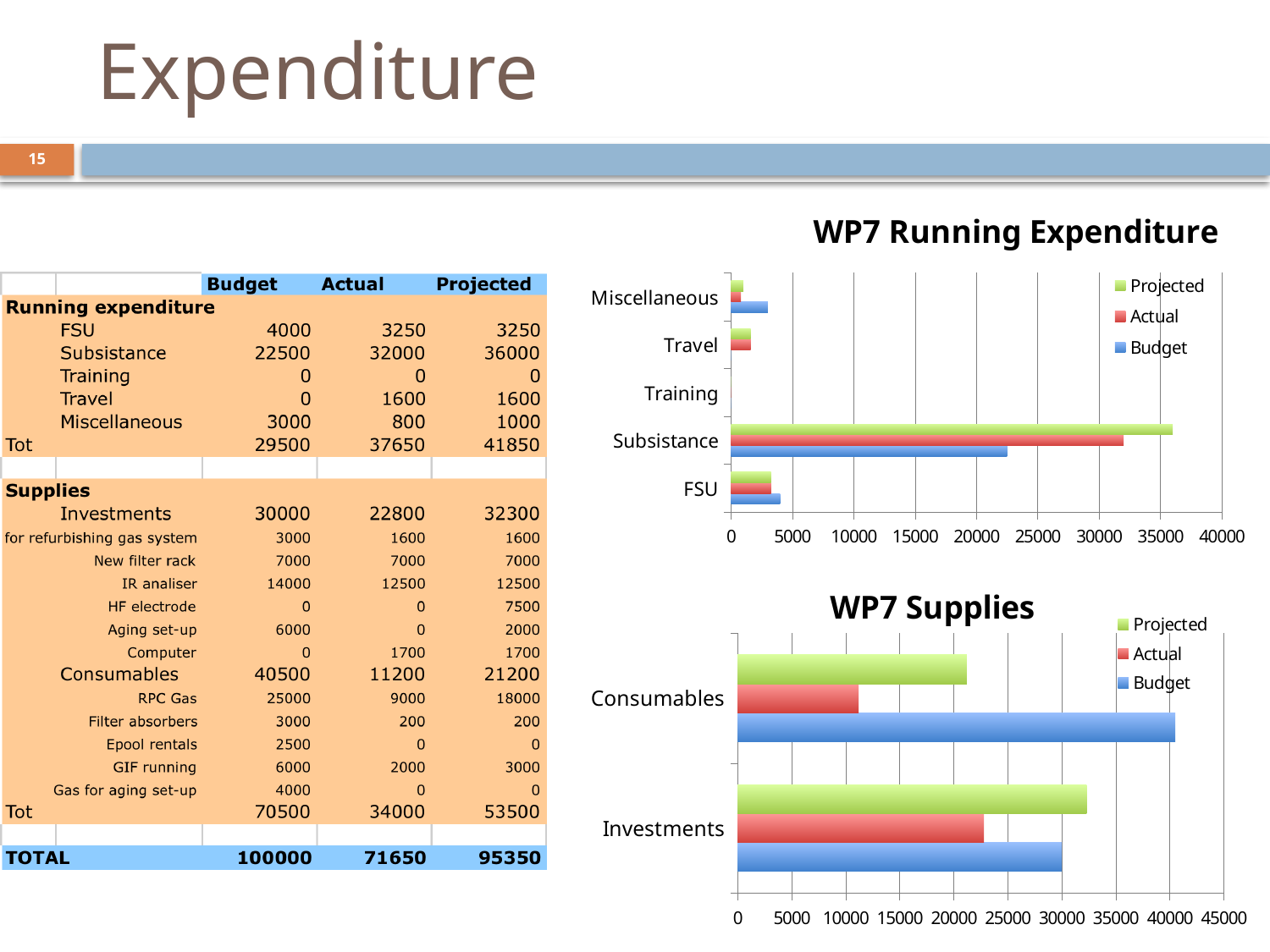
On the WP7 Supplies chart, is the Projected value for Investments greater or less than 30000? greater How many categories are shown on the WP7 Running Expenditure chart? 5 How many series does the legend of the WP7 Running Expenditure chart list? 3 On the WP7 Running Expenditure chart, is the Budget value for FSU greater or less than 5000? less On the WP7 Supplies chart, which is larger, the Actual value for Consumables or the Actual value for Investments? Investments On the WP7 Running Expenditure chart, which category shows no bars at all? Training What type of chart is the WP7 Running Expenditure chart? bar chart On the WP7 Running Expenditure chart, which category has the highest Projected value? Subsistance On the WP7 Running Expenditure chart, is the Budget value for Subsistance greater or less than 25000? less On the WP7 Supplies chart, which is larger, the Budget value for Consumables or the Budget value for Investments? Consumables How many categories are shown on the WP7 Supplies chart? 2